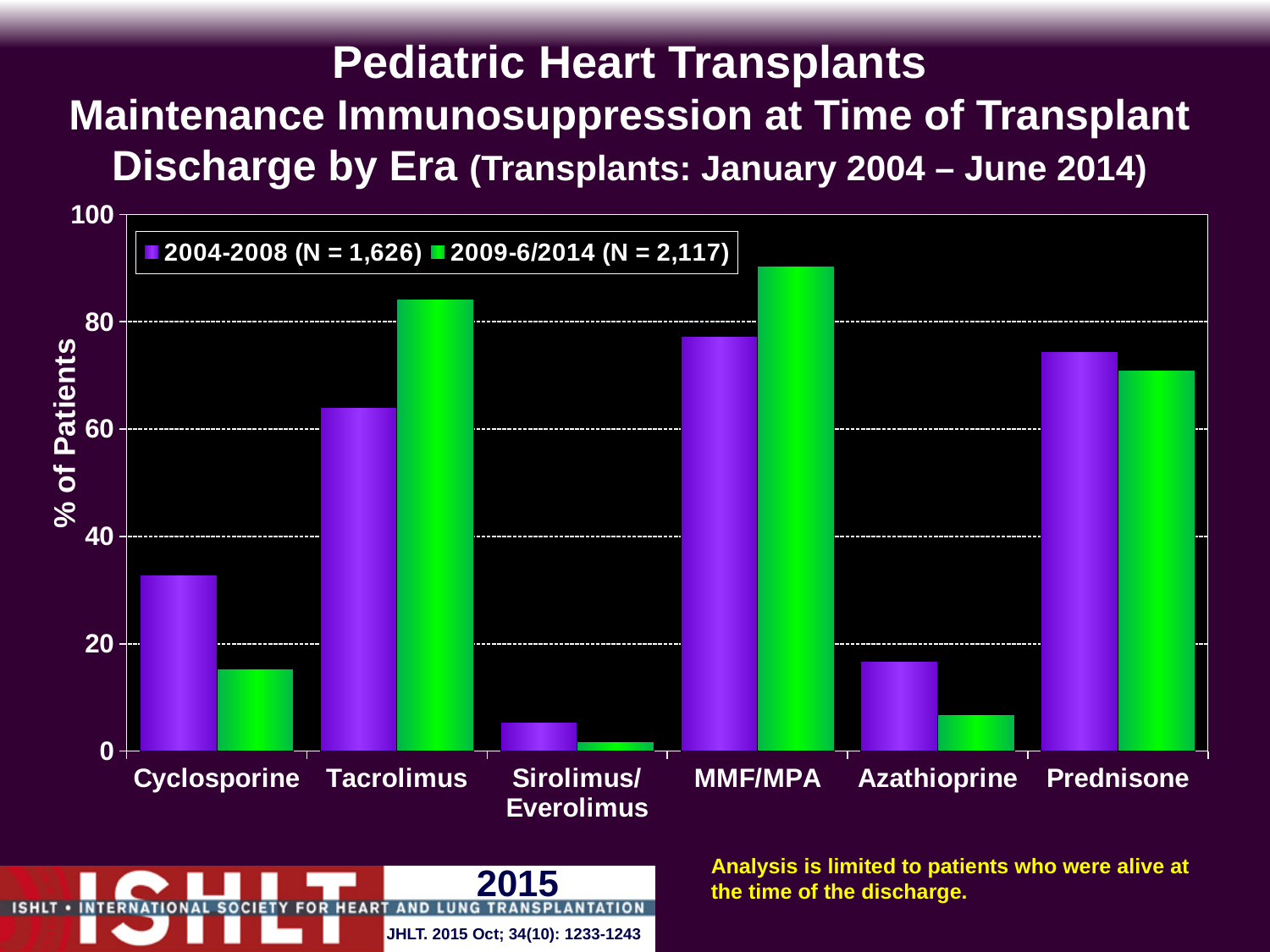
How many series does the legend list? 2 How many drug categories are shown on the x axis? 6 Which drug has the lowest value for the 2009-6/2014 series? Sirolimus/Everolimus Is the value for Tacrolimus in 2009-6/2014 greater or less than 80? greater For Cyclosporine, which era has the larger value, 2004-2008 or 2009-6/2014? 2004-2008 What kind of chart is shown on the slide? bar chart What is the label of the y axis? % of Patients For Tacrolimus, which era has the larger value, 2004-2008 or 2009-6/2014? 2009-6/2014 Which drug has the highest value for the 2009-6/2014 series? MMF/MPA Is the value for Cyclosporine in 2004-2008 greater or less than 20? greater Is the value for Azathioprine in 2009-6/2014 greater or less than 20? less Which drug has the lowest value for the 2004-2008 series? Sirolimus/Everolimus